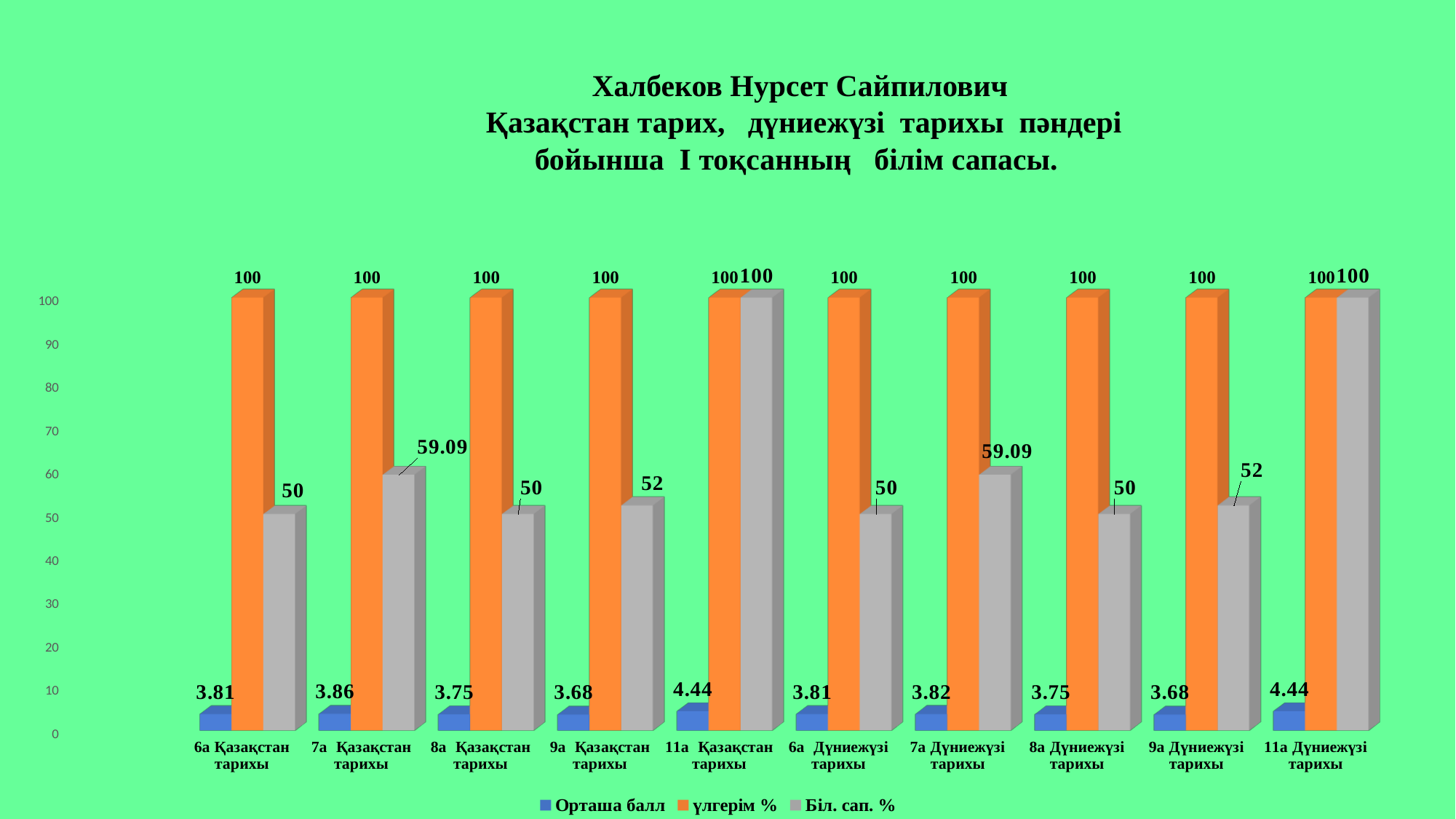
How many series does the legend list? 3 What is the Біл. сап. % value for 9а Қазақстан тарихы? 52 What type of chart is shown on the slide? bar chart What is the Орташа балл value for 11а Дүниежүзі тарихы? 4.44 What is the үлгерім % value for 8а Дүниежүзі тарихы? 100 Which category has the lowest Орташа балл among the Дүниежүзі тарихы classes? 9а Дүниежүзі тарихы How many categories are shown on the x axis? 10 What is the difference between the Біл. сап. % values for 7а Қазақстан тарихы and 8а Қазақстан тарихы? 9.09 What is the Біл. сап. % value for 7а Қазақстан тарихы? 59.09 Which series is shown in orange in the legend? үлгерім % Which is larger, the Орташа балл for 7а Қазақстан тарихы or for 7а Дүниежүзі тарихы? 7а Қазақстан тарихы Which category has the highest Орташа балл among the Қазақстан тарихы classes? 11а Қазақстан тарихы